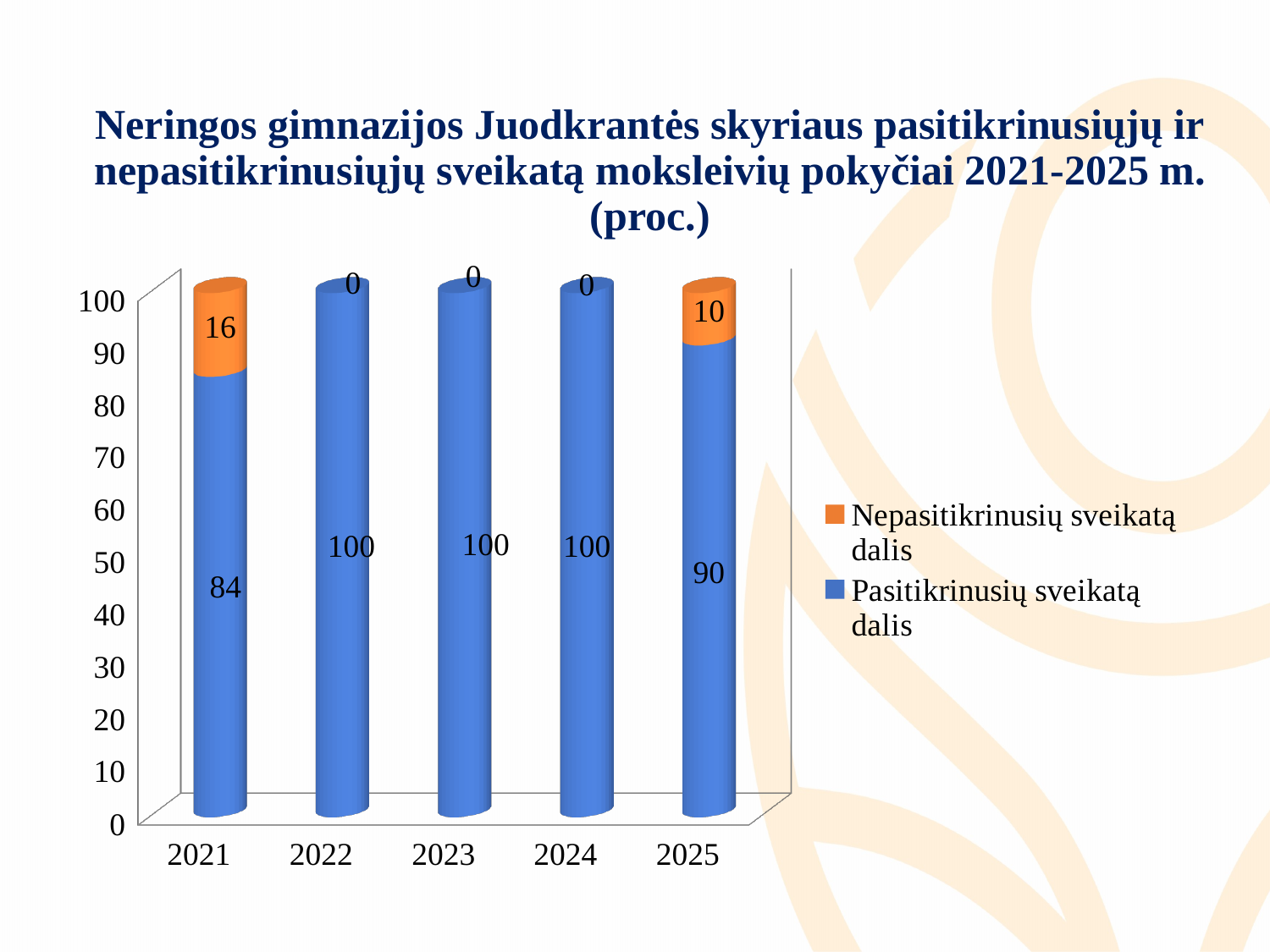
What is the value for "Nepasitikrinusių sveikatą dalis" in 2021? 16 In which year is the value for "Nepasitikrinusių sveikatą dalis" highest? 2021 What is the value for "Nepasitikrinusių sveikatą dalis" in 2025? 10 What is the difference between the "Pasitikrinusių sveikatą dalis" values for 2025 and 2021? 6 What kind of chart is shown on the slide? Stacked bar chart What is the value for "Pasitikrinusių sveikatą dalis" in 2021? 84 How many series does the legend list? 2 What is the total of the stacked bar for 2021? 100 In which year is the value for "Pasitikrinusių sveikatą dalis" lowest? 2021 How many years are shown on the x axis? 5 Which is larger: the "Nepasitikrinusių sveikatą dalis" value for 2021 or for 2025? 2021 What is the value for "Pasitikrinusių sveikatą dalis" in 2023? 100